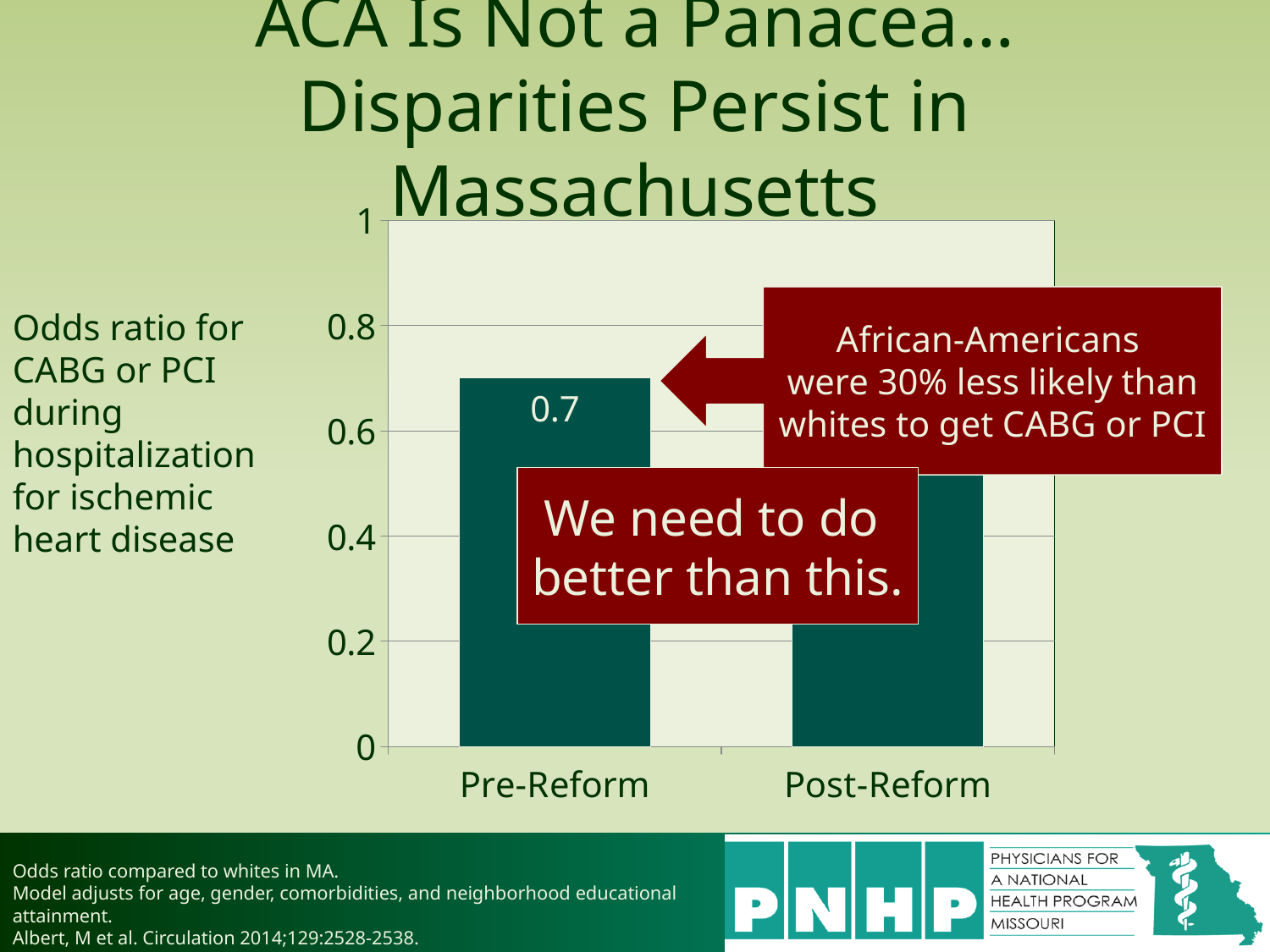
What kind of chart is shown on the slide? bar chart Is the value for Pre-Reform greater or less than 0.6? greater What are the two category labels on the x axis? Pre-Reform and Post-Reform What is the odds ratio value shown for Pre-Reform? 0.7 How many bars are plotted in the chart? 2 What is the highest tick value shown on the y axis? 1 Is the value for Post-Reform greater or less than 0.4? greater